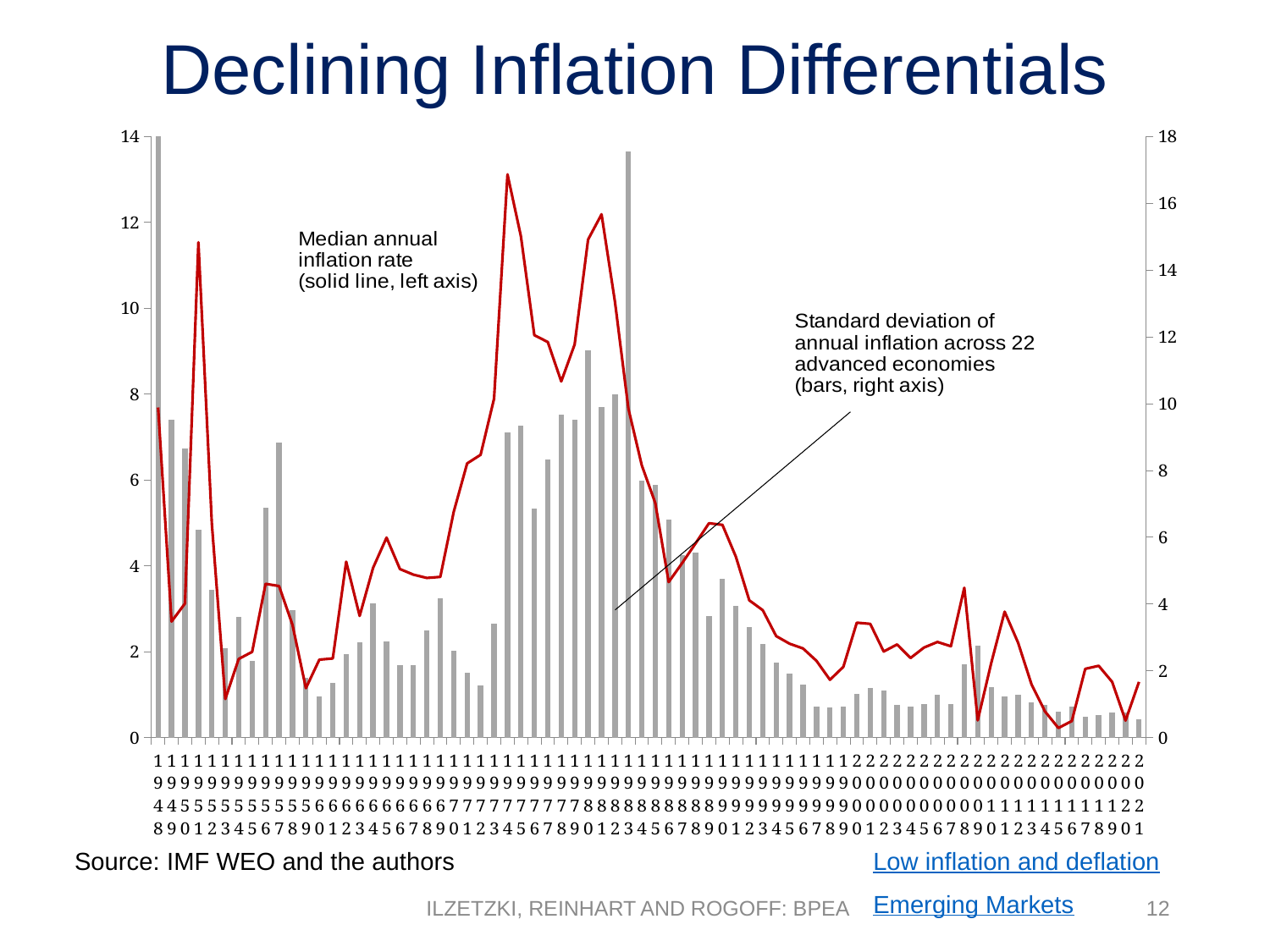
Which year has the higher median annual inflation rate, 1974 or 1980? 1974 In which year does the median annual inflation rate (solid line) reach its highest value? 1974 Is the median annual inflation rate in 1974 greater or less than 12 on the left axis? greater Is the standard deviation of annual inflation in 2021 greater or less than 2 on the right axis? less Which series is plotted as bars on the right axis? Standard deviation of annual inflation across 22 advanced economies What is the title of the chart? Declining Inflation Differentials What kind of chart is shown on the slide? A combined bar and line chart Is the median annual inflation rate in 1951 greater or less than 10 on the left axis? greater Do the standard deviation bars generally rise or fall from 1980 to 2021? fall How many data series does the chart plot? 2 Which year has the higher standard deviation of annual inflation, 1974 or 1980? 1980